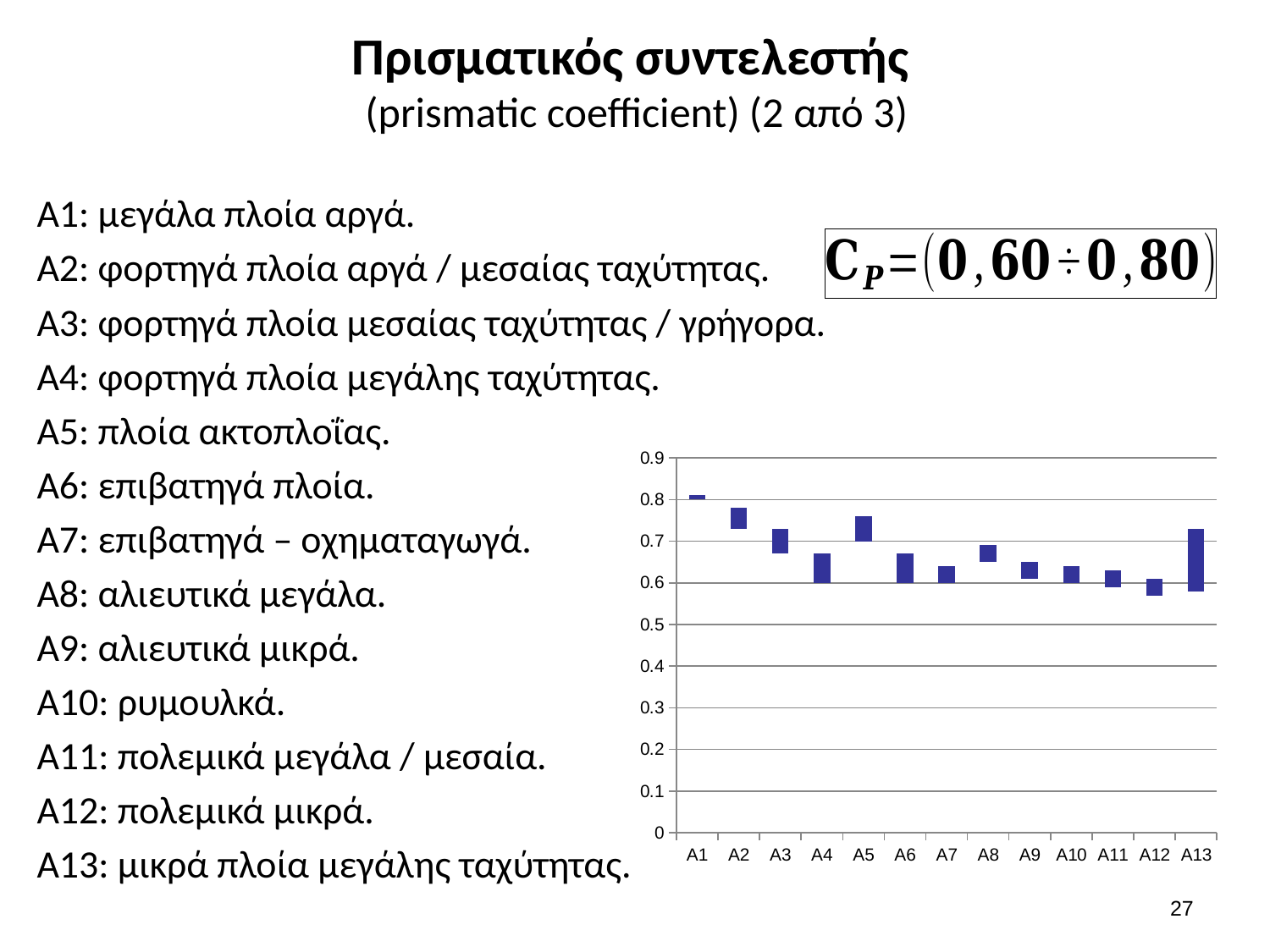
Which category has the highest bar in the chart? A1 Do the bar values generally rise or fall from A1 to A12 along the x axis? fall Is the top of the bar for A10 greater or less than 0.7? less Is the bar for A1 greater or less than 0.5? greater Is the top of the bar for A5 greater or less than 0.7? greater Which bar is taller, A2 or A12? A2 What is the maximum value shown on the y axis of the chart? 0.9 How many categories are shown on the x axis of the chart? 13 What kind of chart is shown on the slide? bar chart